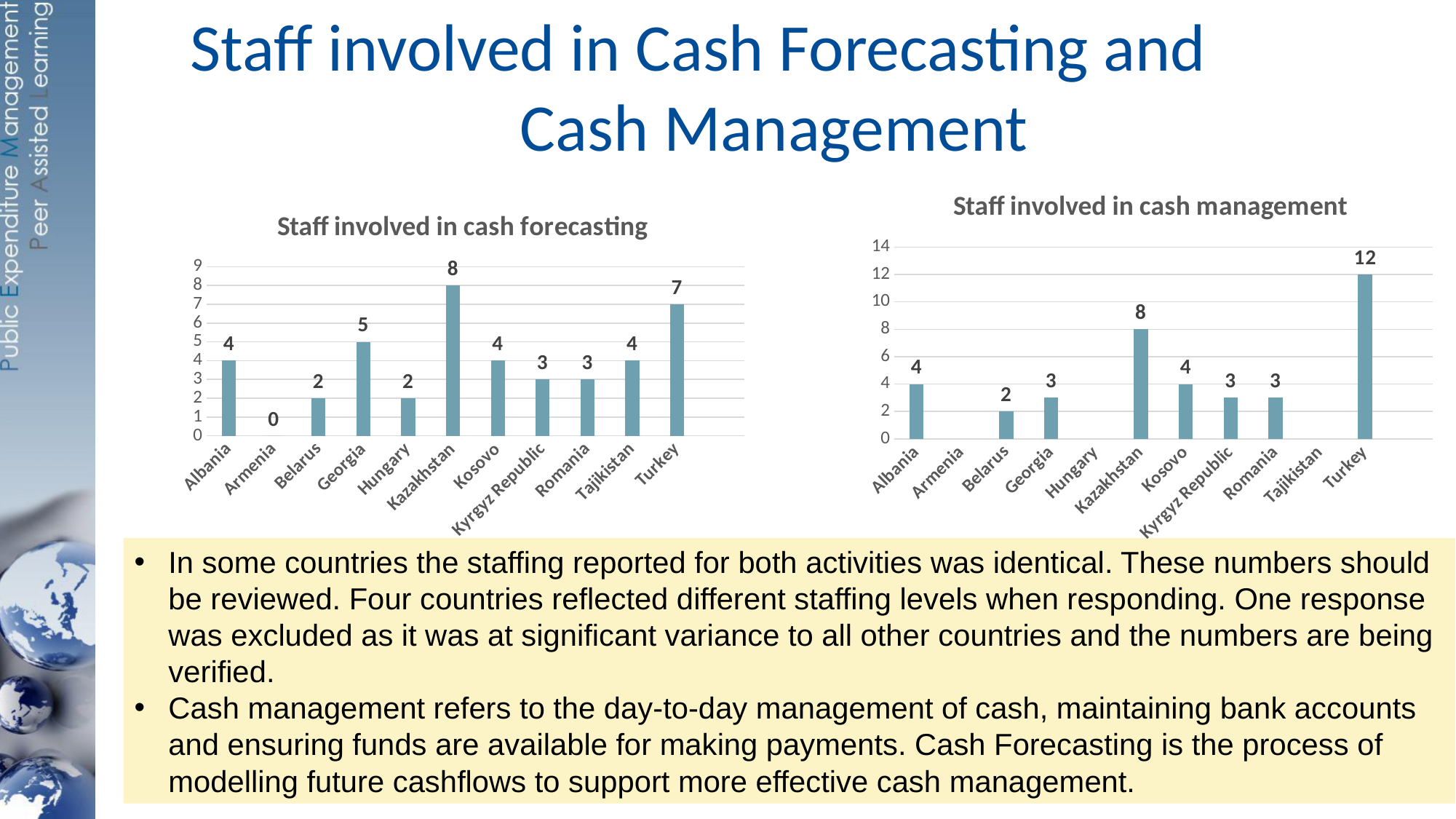
In the 'Staff involved in cash forecasting' chart, what is the difference between the values for Turkey and Hungary? 5 What type of chart is the 'Staff involved in cash management' chart? Bar chart What is the title of the chart on the left of the slide? Staff involved in cash forecasting In the 'Staff involved in cash management' chart, which is larger, the value for Georgia or the value for Kosovo? Kosovo In the 'Staff involved in cash forecasting' chart, what is the value for Georgia? 5 In the 'Staff involved in cash forecasting' chart, which country has the highest value? Kazakhstan In the 'Staff involved in cash forecasting' chart, how many countries are shown on the x axis? 11 In the 'Staff involved in cash forecasting' chart, what is the value for Kazakhstan? 8 In the 'Staff involved in cash forecasting' chart, which country has the lowest value? Armenia In the 'Staff involved in cash management' chart, what is the value for Turkey? 12 In the 'Staff involved in cash management' chart, what is the difference between the values for Turkey and Kazakhstan? 4 In the 'Staff involved in cash management' chart, which country has the highest value? Turkey